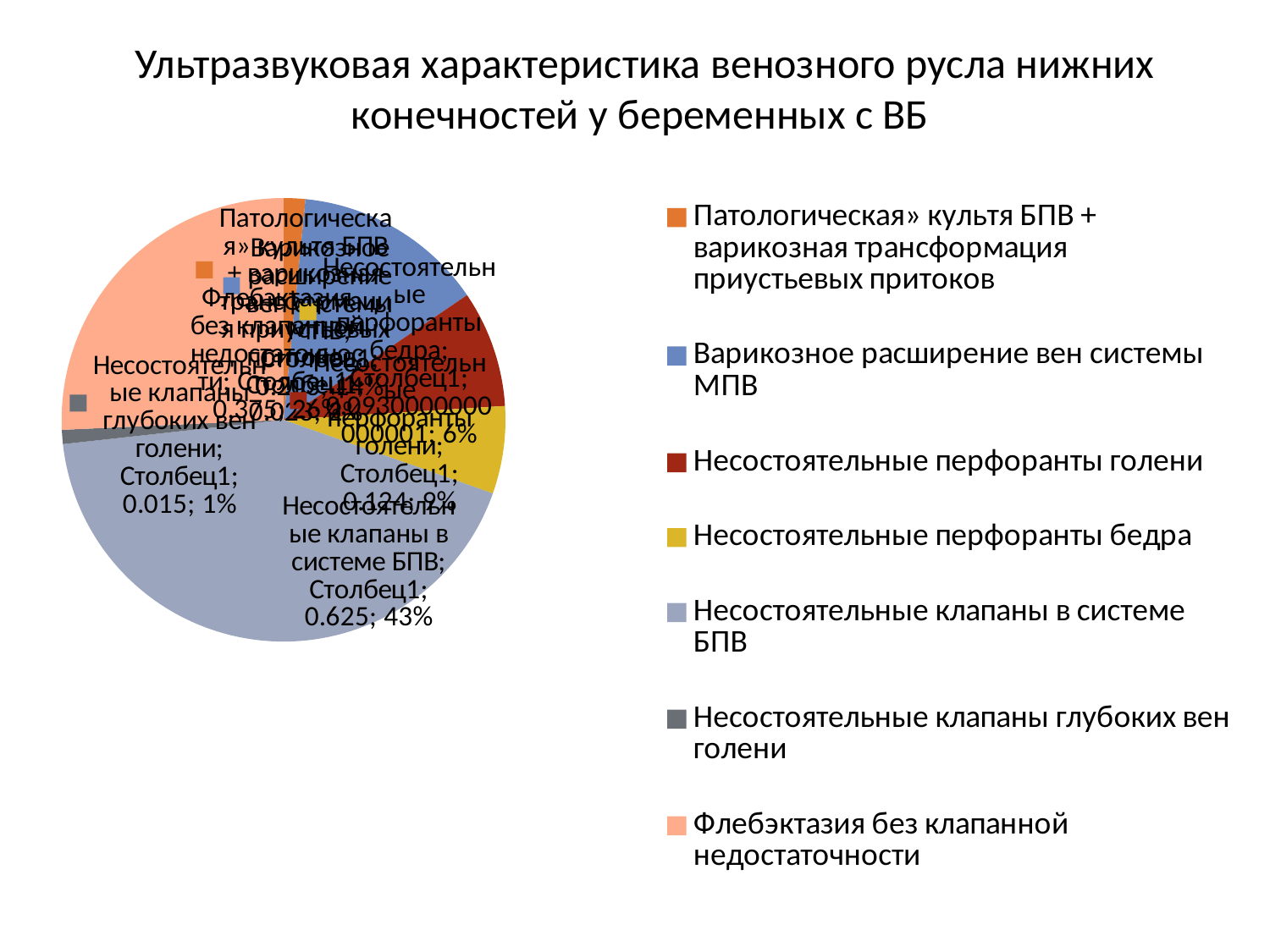
What is the difference in percentage points between the share of "Несостоятельные клапаны в системе БПВ" (43%) and "Несостоятельные клапаны глубоких вен голени" (1%)? 42 What value is printed for "Несостоятельные клапаны в системе БПВ"? 0.625 What colour is used for "Несостоятельные перфоранты бедра" in the legend? yellow What value is printed for "Несостоятельные клапаны глубоких вен голени"? 0.015 How many entries does the legend of the pie chart list? 7 What share of the pie does "Несостоятельные клапаны глубоких вен голени" take? 1% Which category has the smallest slice of the pie? Несостоятельные клапаны глубоких вен голени Which is larger: the slice for "Несостоятельные клапаны в системе БПВ" or the slice for "Несостоятельные клапаны глубоких вен голени"? Несостоятельные клапаны в системе БПВ What kind of chart is shown on the slide? pie chart What is the title of the slide containing the pie chart? Ультразвуковая характеристика венозного русла нижних конечностей у беременных с ВБ Which category has the largest slice of the pie? Несостоятельные клапаны в системе БПВ What share of the pie does "Несостоятельные клапаны в системе БПВ" take? 43%